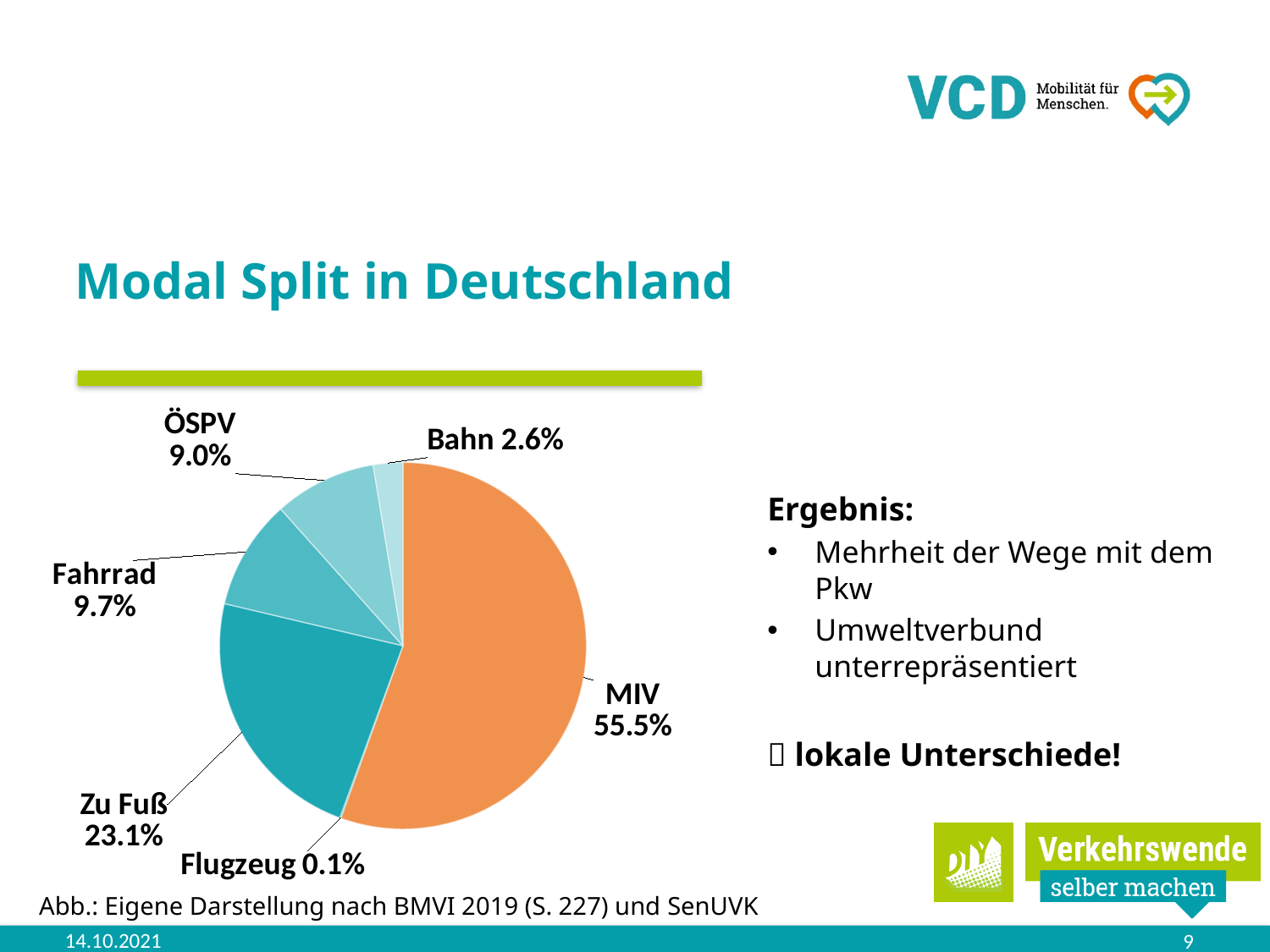
What is the difference between the shares of Zu Fuß and Fahrrad? 13.4% What kind of chart is shown on the slide? pie chart Which category has the smallest slice of the pie? Flugzeug How many categories are shown in the pie chart? 6 What is the combined share of ÖSPV and Bahn? 11.6% Which category has the largest slice of the pie? MIV What is the value for Zu Fuß? 23.1% What share of the pie does MIV have? 55.5% Which is larger, the share for Fahrrad or the share for ÖSPV? Fahrrad What is the title of the slide containing the chart? Modal Split in Deutschland What is the value for Bahn? 2.6% What is the value for Fahrrad? 9.7%